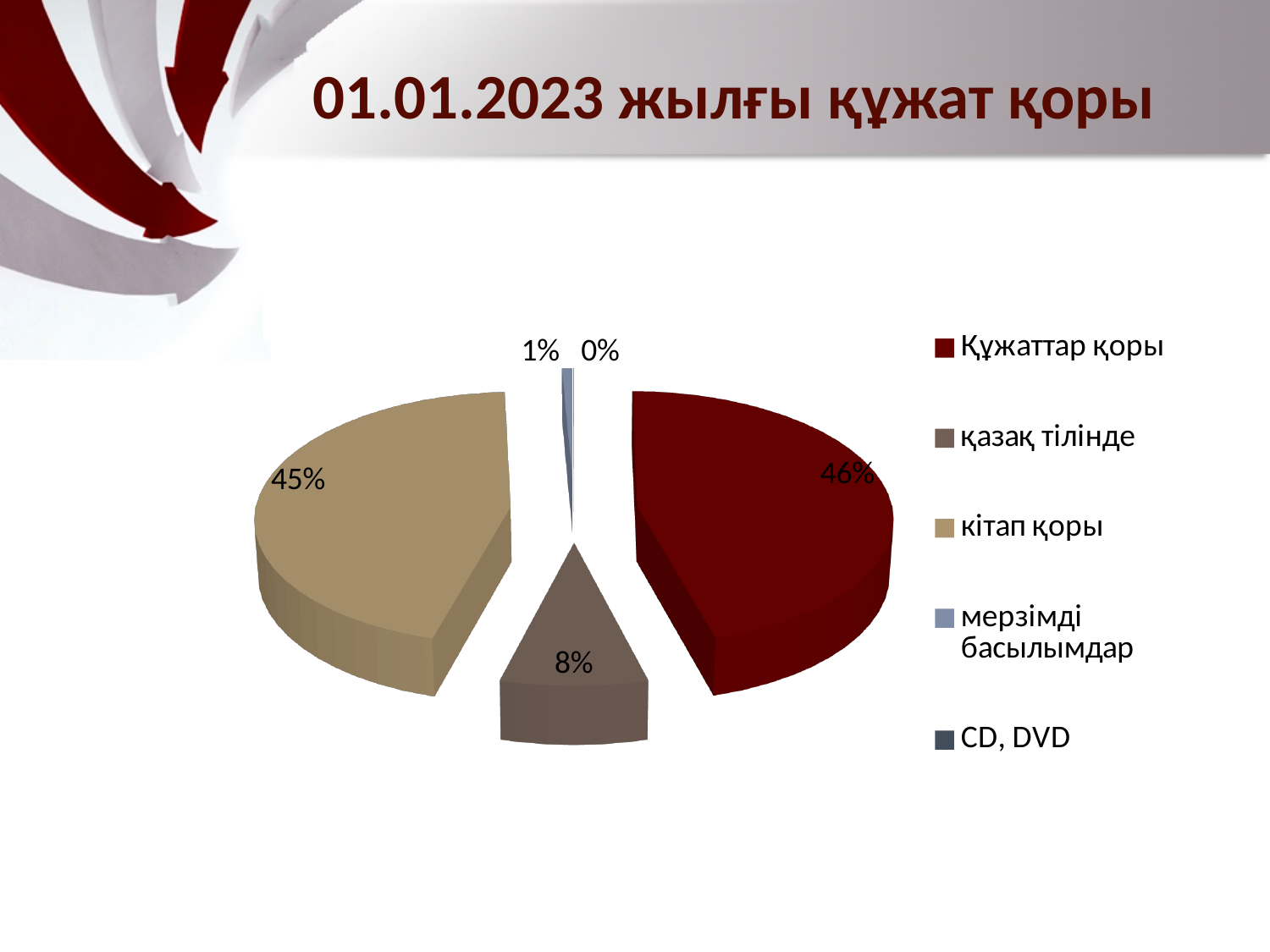
Which category has the largest share of the pie? Құжаттар қоры What share of the pie does кітап қоры take? 45% What is the title of the chart on the slide? 01.01.2023 жылғы құжат қоры What share of the pie does мерзімді басылымдар take? 1% What is the difference between the shares of кітап қоры and қазақ тілінде? 37% Which category has the smallest share of the pie? CD, DVD What share of the pie does Құжаттар қоры take? 46% Which colour represents кітап қоры in the chart? tan What kind of chart is shown on the slide? pie chart How many entries does the chart legend list? 5